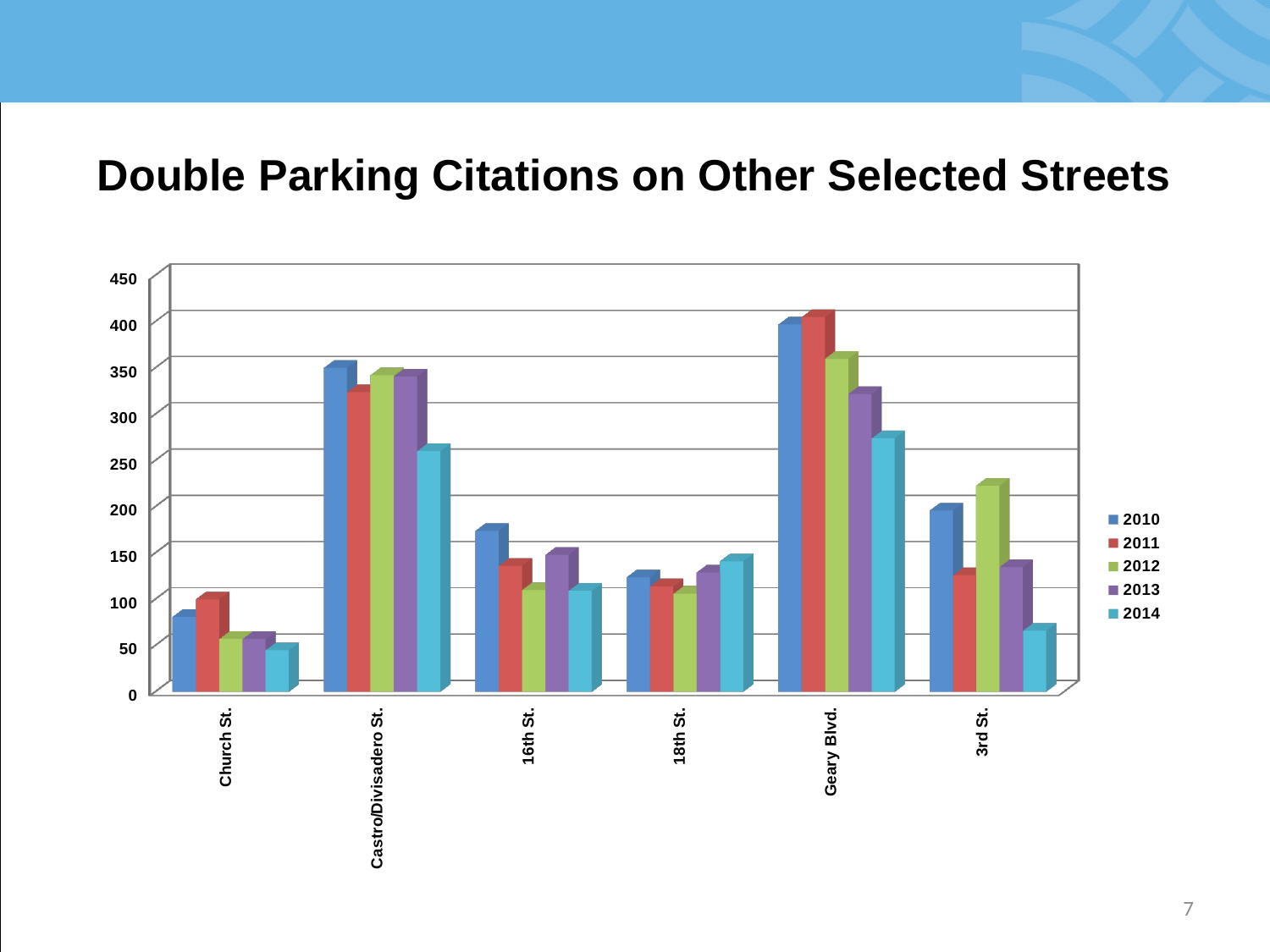
Do the values for Geary Blvd. rise or fall from 2011 to 2014? Fall For 3rd St., which year has the highest number of citations? 2012 Which street has the highest number of citations in 2010? Geary Blvd. Which street has the lowest number of citations in 2014? Church St. Is the value for 3rd St. in 2012 greater or less than 200? greater What is the title of the chart? Double Parking Citations on Other Selected Streets How many series does the legend list? 5 What kind of chart is shown on the slide? Bar chart Which is larger: the 2010 value for Castro/Divisadero St. or the 2010 value for 16th St.? Castro/Divisadero St. Is the value for Geary Blvd. in 2011 greater or less than 350? greater Is the value for Castro/Divisadero St. in 2014 greater or less than 300? less How many streets are shown on the x axis? 6